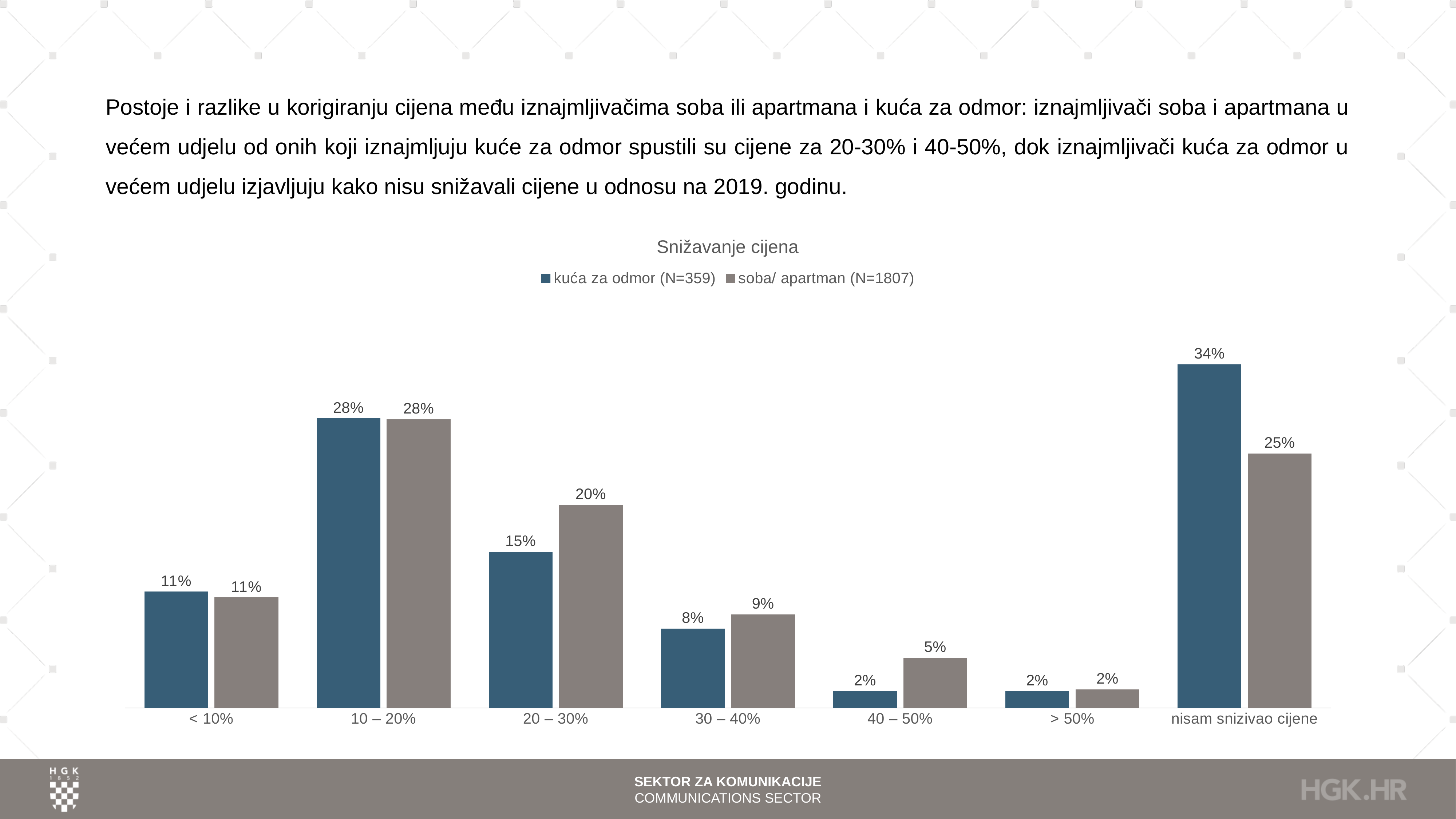
Which category has the highest value for 'kuća za odmor (N=359)'? nisam snizivao cijene What is the difference between the 'soba/ apartman (N=1807)' and 'kuća za odmor (N=359)' values in the '20 – 30%' category? 5% What is the value for 'kuća za odmor (N=359)' in the 'nisam snizivao cijene' category? 34% How many series does the legend list? 2 What is the value for 'soba/ apartman (N=1807)' in the '40 – 50%' category? 5% How many categories are shown on the x axis? 7 Which category has the highest value for 'soba/ apartman (N=1807)'? 10 – 20% What kind of chart is shown on the slide? bar chart What is the title of the chart? Snižavanje cijena What is the difference between the 'kuća za odmor (N=359)' and 'soba/ apartman (N=1807)' values in the 'nisam snizivao cijene' category? 9% What is the value for 'soba/ apartman (N=1807)' in the '20 – 30%' category? 20% In the '20 – 30%' category, which series has the larger value? soba/ apartman (N=1807)